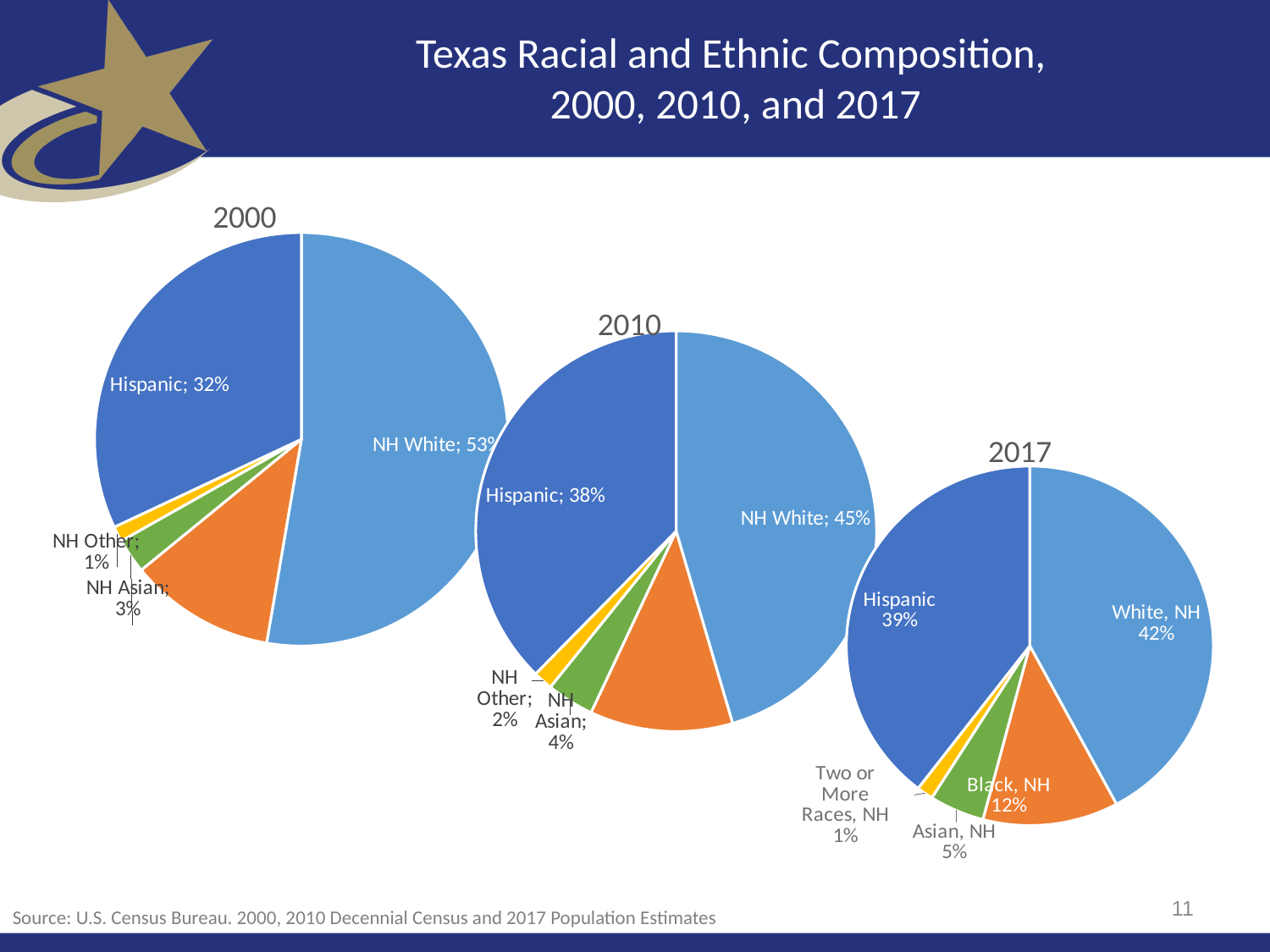
Across the 2000, 2010 and 2017 pie charts, does the Hispanic share rise or fall over time? Rise In the 2000 pie chart, which is larger, the NH Asian share or the NH Other share? NH Asian In the 2017 pie chart, which group has the largest share? White, NH In the 2017 pie chart, what share is Black, NH? 12% In the 2017 pie chart, which group has the smallest share? Two or More Races, NH In the 2010 pie chart, what share is Hispanic? 38% How many pie charts are on the slide? 3 In the 2010 pie chart, what share is NH Asian? 4% In the 2000 pie chart, what share is NH White? 53% In the 2010 pie chart, what is the difference between the NH White share and the Hispanic share? 7% What kind of charts are shown on the slide? Pie charts In the 2000 pie chart, what share is Hispanic? 32%